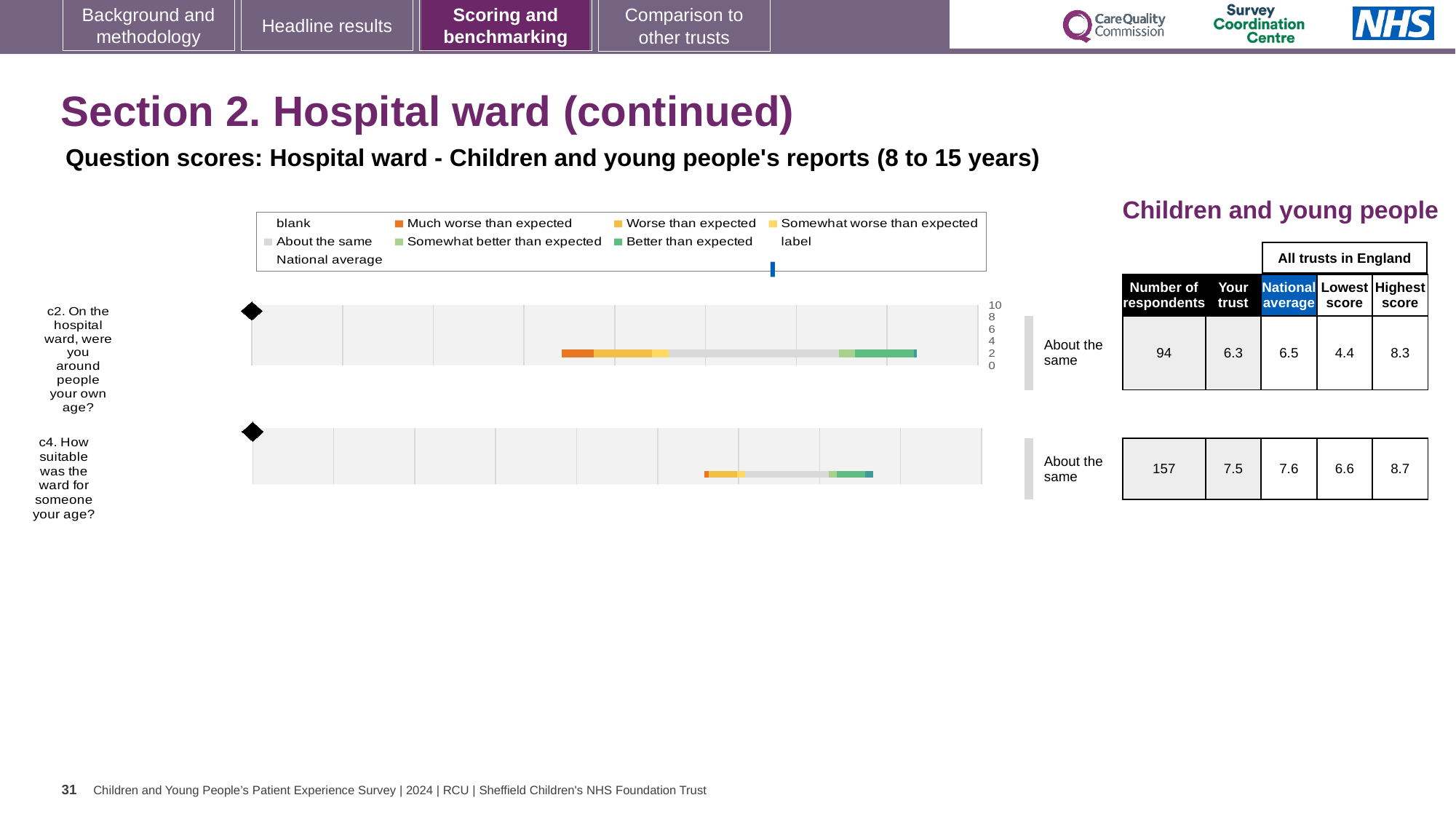
Which question has the higher 'Your trust' score, c2 or c4? c4 What is the difference between the 'Your trust' scores for c4 and c2? 1.2 What is the difference between the lowest scores for c4 and c2? 2.2 Which legend entry is shown in orange? Much worse than expected How many survey questions are plotted on the chart? 2 What is the 'Your trust' score for question c2 (On the hospital ward, were you around people your own age?)? 6.3 What benchmark rating is shown for question c2? About the same How many respondents answered question c4? 157 What is the national average score for question c2? 6.5 What is the 'Your trust' score for question c4 (How suitable was the ward for someone your age?)? 7.5 What is the highest score across all trusts in England for question c4? 8.7 What kind of chart is used to show the question scores? bar chart